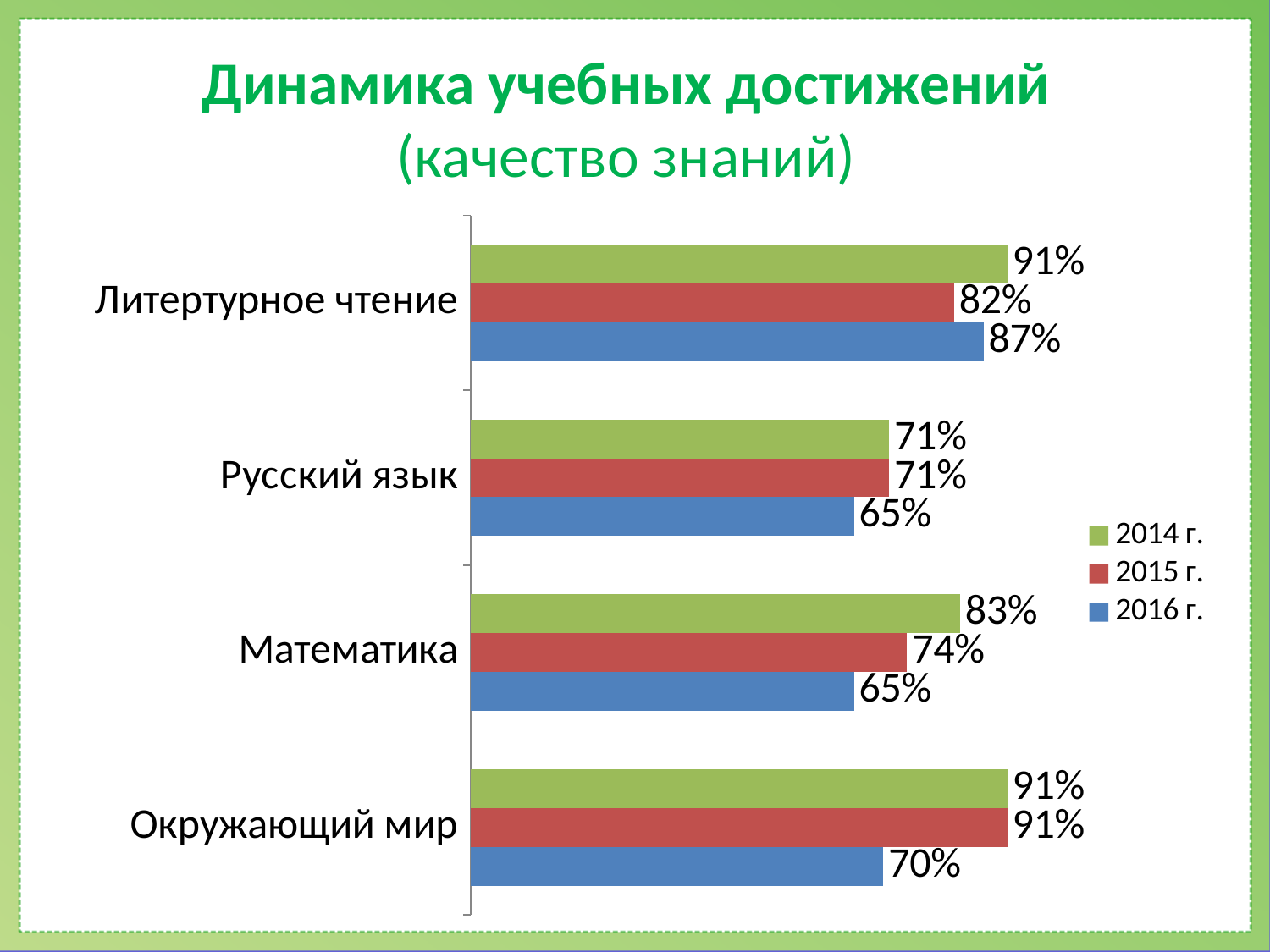
What is the value for Математика in 2015 г.? 74% Which is larger for Литертурное чтение: the 2015 г. value or the 2016 г. value? 2016 г. What is the value for Русский язык in 2014 г.? 71% What kind of chart is shown on the slide? Bar chart How many categories are shown on the chart? 4 What is the difference between the 2014 г. and 2015 г. values for Математика? 9% Which category has the lowest value in the 2016 г. series? Русский язык and Математика (both 65%) What is the difference between the 2014 г. and 2016 г. values for Окружающий мир? 21% How many series does the legend list? 3 What is the value for Окружающий мир in 2016 г.? 70% Which category has the highest value in the 2015 г. series? Окружающий мир What is the value for Литертурное чтение in 2016 г.? 87%